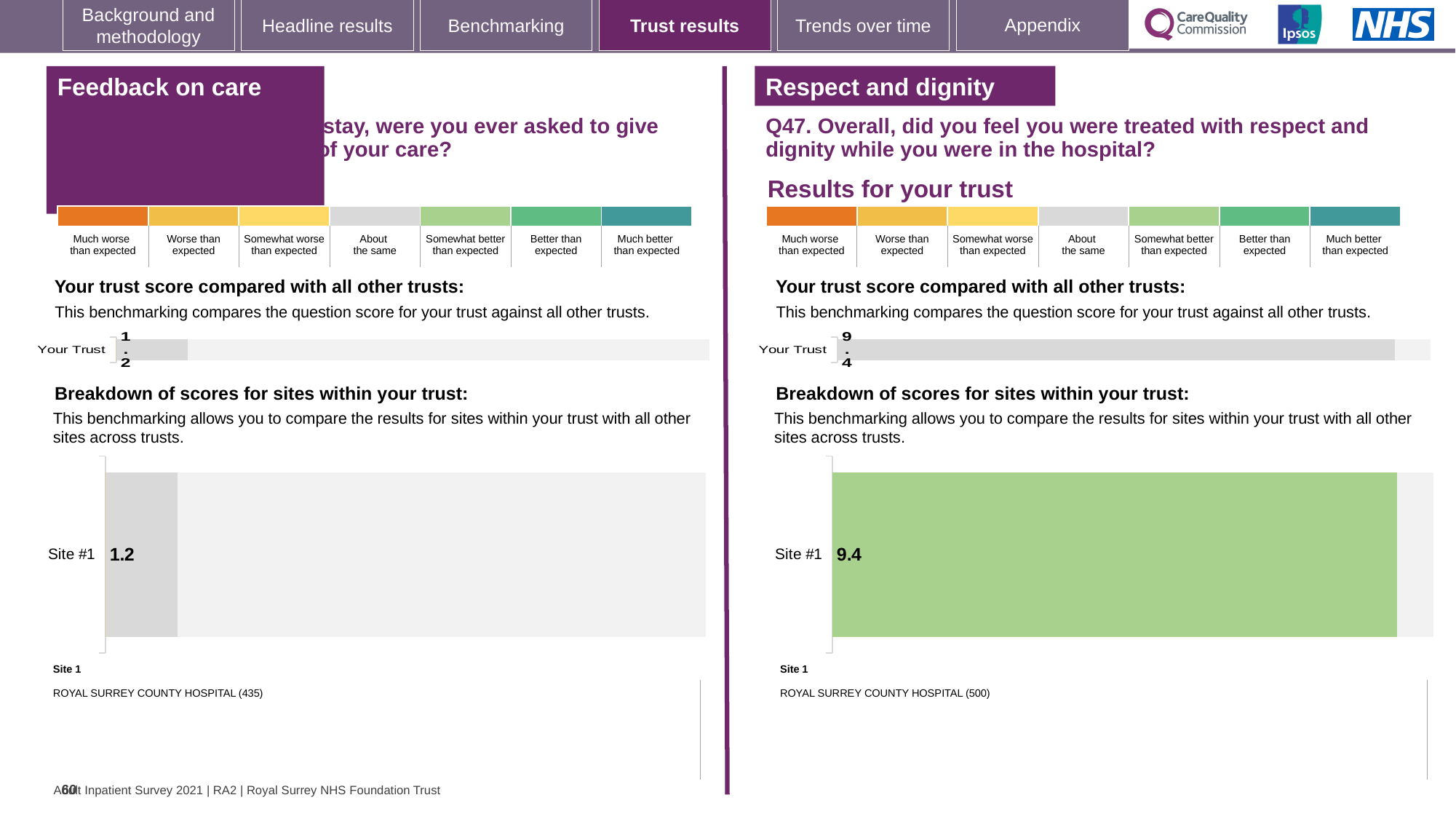
Which Site #1 score is larger: the one on the 'Feedback on care' side or the one on the 'Respect and dignity' side? Respect and dignity What type of chart is used to show the Site #1 score on the 'Feedback on care' side? Bar chart On the 'Respect and dignity' side, what is the 'Your Trust' score in the chart comparing the trust score with all other trusts? 9.4 On the 'Feedback on care' side, what is the score shown for Site #1 in the breakdown of scores for sites within your trust? 1.2 How many sites are shown in the breakdown of scores chart on the 'Feedback on care' side? 1 On the 'Respect and dignity' side, what is the score shown for Site #1 in the breakdown of scores for sites within your trust? 9.4 On the 'Feedback on care' side, what is the 'Your Trust' score in the chart comparing the trust score with all other trusts? 1.2 How many sites are shown in the breakdown of scores chart on the 'Respect and dignity' side? 1 What colour is the Site #1 bar in the breakdown chart on the 'Respect and dignity' side? Green Which site name is listed as Site 1 below the breakdown chart on the 'Feedback on care' side? ROYAL SURREY COUNTY HOSPITAL (435) What is the difference between the Site #1 score on the 'Respect and dignity' side and the Site #1 score on the 'Feedback on care' side? 8.2